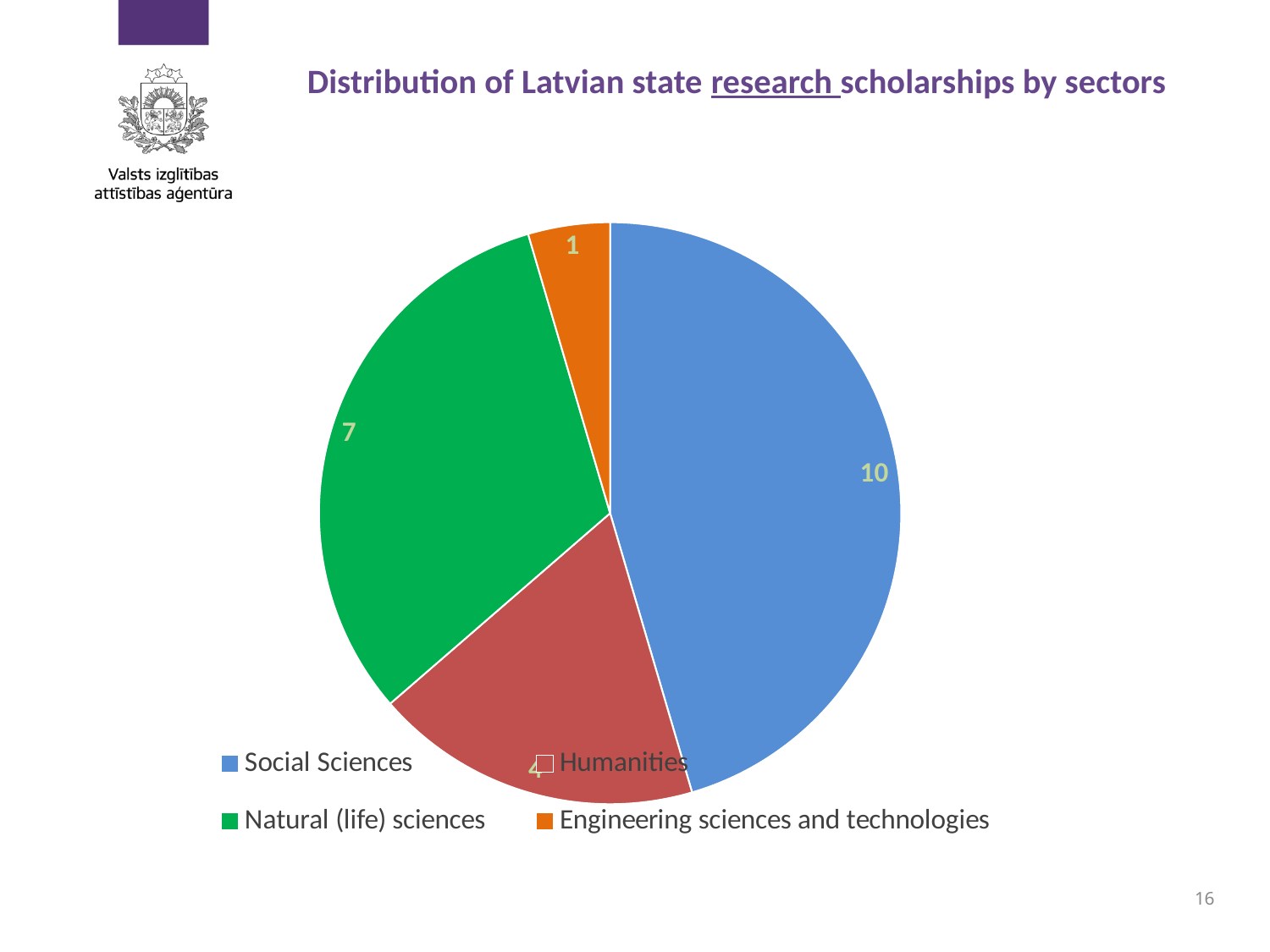
What is the total of all values shown in the pie chart? 22 What is the value for Social Sciences? 10 What is the value for Natural (life) sciences? 7 Which sector has the smallest share of scholarships? Engineering sciences and technologies How many sectors are shown in the pie chart? 4 Which sector has the largest share of scholarships? Social Sciences What is the value for Humanities? 4 What kind of chart is shown on the slide? pie chart What is the value for Engineering sciences and technologies? 1 What is the title of the chart? Distribution of Latvian state research scholarships by sectors Which is larger, the value for Humanities or the value for Natural (life) sciences? Natural (life) sciences What is the difference between the values for Social Sciences and Natural (life) sciences? 3